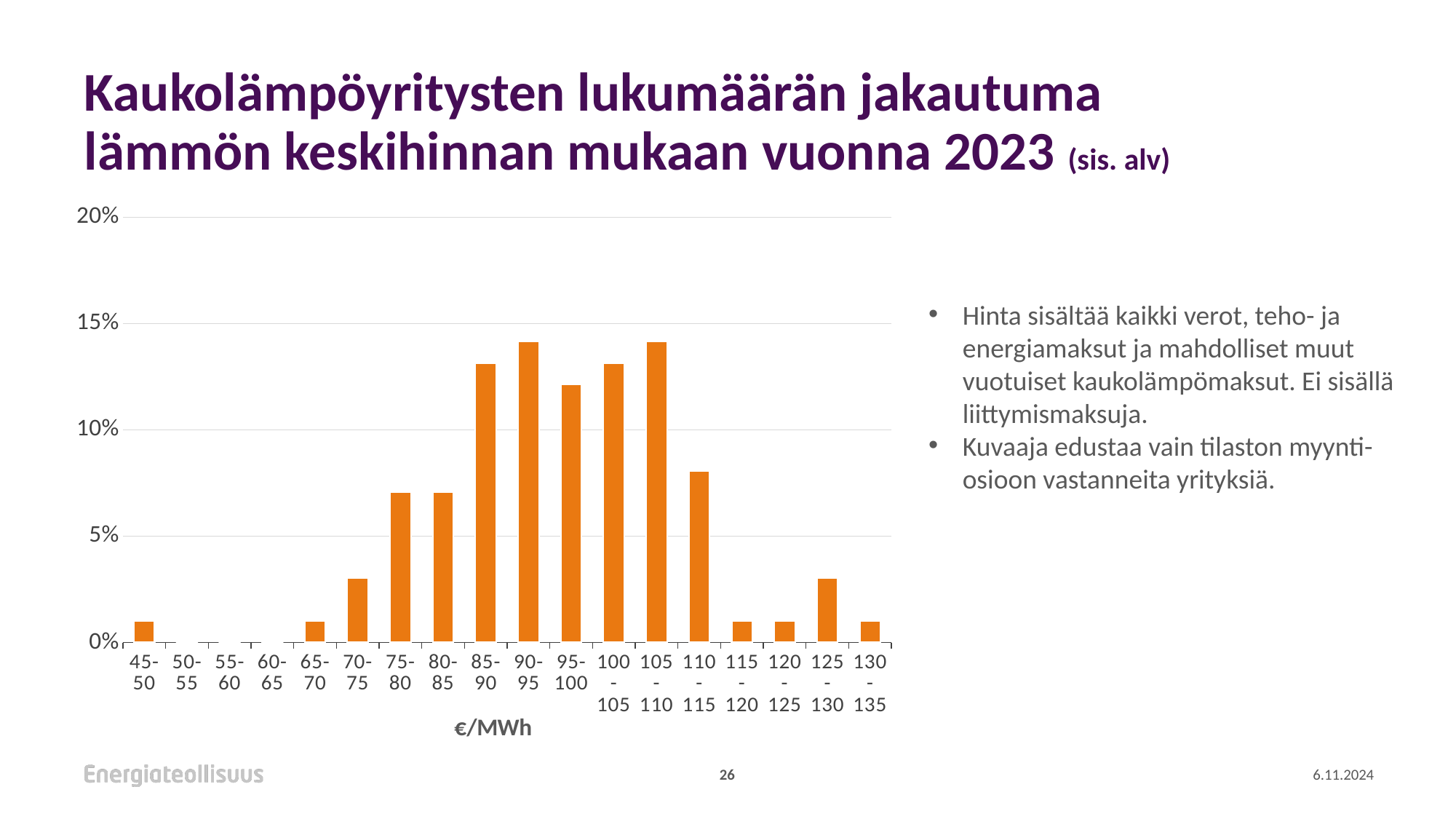
Is the value for the 85-90 category greater or less than 10%? greater Do the values rise or fall from the 110-115 category to the 115-120 category? fall Is the value for the 125-130 category greater or less than 5%? less What is the label of the x axis of the chart? €/MWh Which category has the larger value, 110-115 or 125-130? 110-115 Is the value for the 90-95 category greater or less than 15%? less How many categories on the chart have no visible bar? 3 Which category has the larger value, 85-90 or 70-75? 85-90 How many price categories are shown on the x axis of the chart? 18 What kind of chart is shown on the slide? bar chart